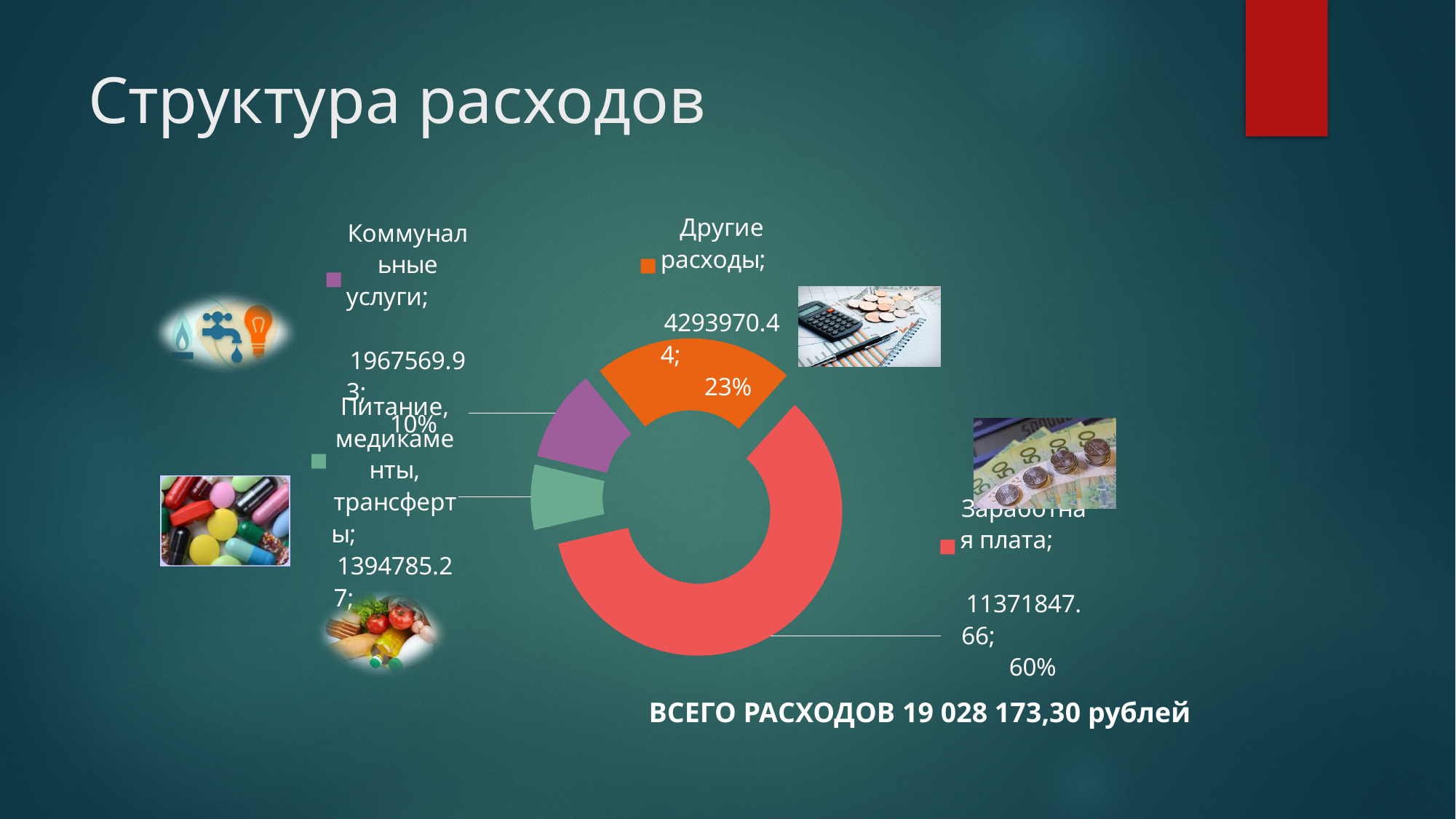
What percentage share does Заработная плата have? 60% How many categories does the chart show? 4 Which is larger, Другие расходы or Коммунальные услуги? Другие расходы What is the difference between Заработная плата and Другие расходы? 7077877.22 What is the value shown for Питание, медикаменты, трансферты? 1394785.27 What kind of chart is shown on the slide? Doughnut (pie) chart Which category has the smallest value? Питание, медикаменты, трансферты What is the value shown for Другие расходы? 4293970.44 What is the value shown for Коммунальные услуги? 1967569.93 Which category has the largest share of expenses? Заработная плата What is the value shown for Заработная плата? 11371847.66 What percentage share does Другие расходы have? 23%